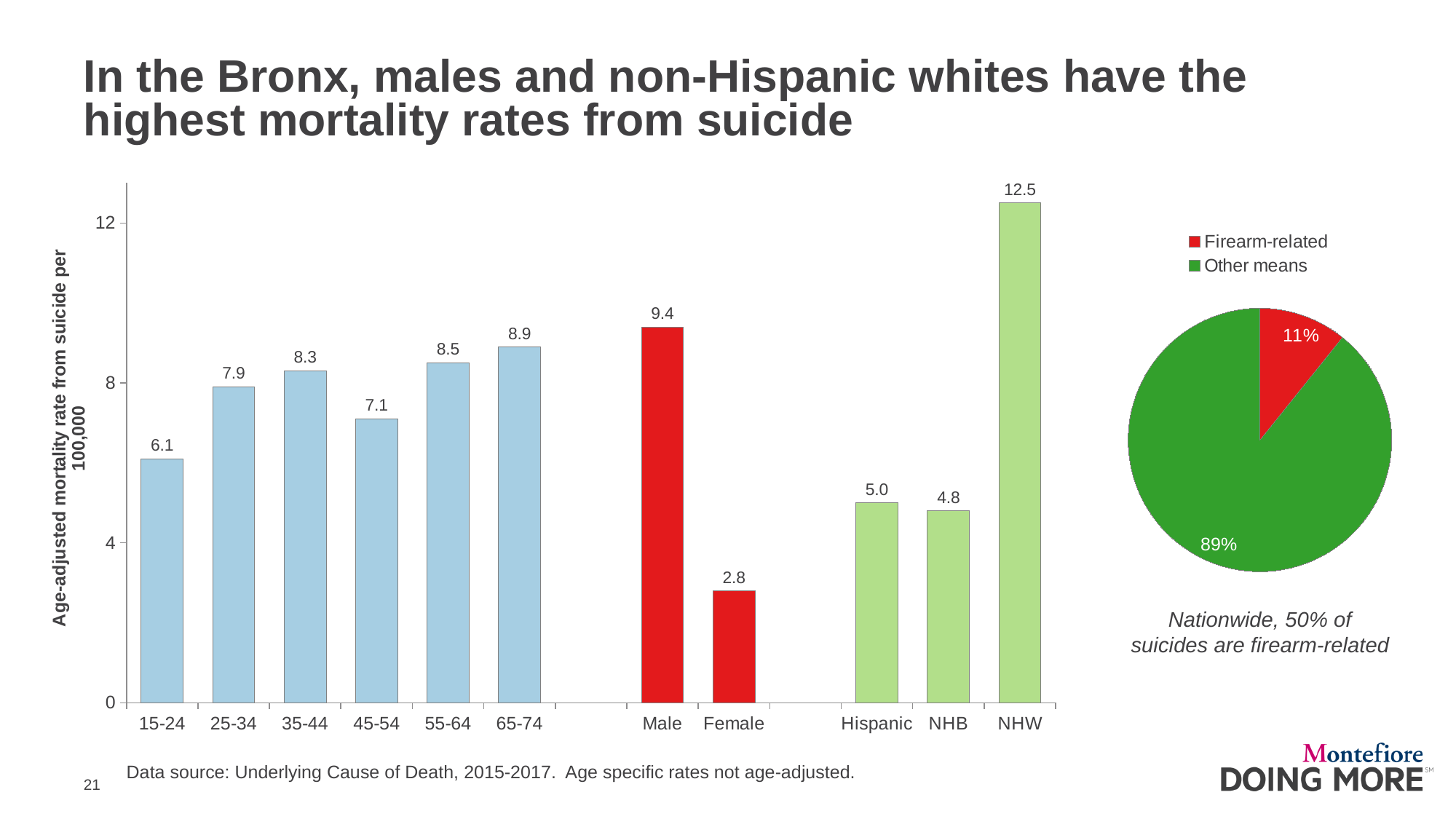
In the pie chart, what share of suicides is firearm-related? 11% In the bar chart, what is the difference between the suicide mortality rates for the 65-74 and 15-24 age groups? 2.8 In the bar chart, what is the difference between the male and female suicide mortality rates? 6.6 In the pie chart, what share of suicides is by other means? 89% In the bar chart, what is the suicide mortality rate for the 45-54 age group? 7.1 In the bar chart, how many categories are shown on the x axis? 11 In the bar chart, which category has the lowest suicide mortality rate? Female What kind of chart is on the left side of the slide? Bar chart How many entries does the pie chart's legend list? 2 In the bar chart, what is the age-adjusted suicide mortality rate for males? 9.4 In the bar chart, which category has the highest suicide mortality rate? NHW In the bar chart, which has a higher suicide mortality rate, Hispanic or NHB? Hispanic